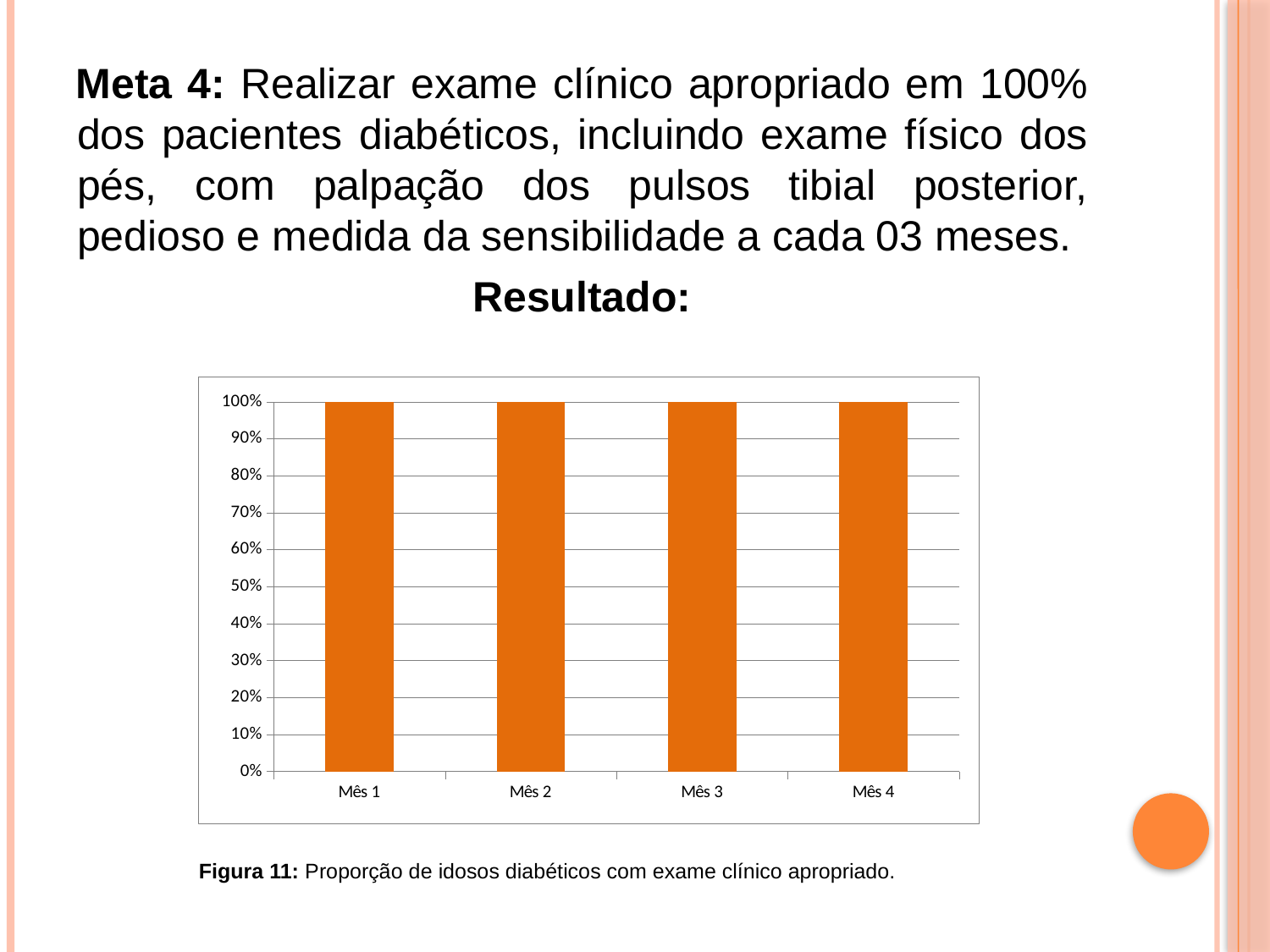
Do the values rise, fall, or stay the same from Mês 1 to Mês 4? stay the same What is the value for Mês 4 in the chart? 100% Is the value for Mês 1 greater or less than 90%? greater What is the difference between the values for Mês 1 and Mês 4? 0% What type of chart is shown on the slide? bar chart What colour are the bars in the chart? orange What is the value for Mês 1 in the chart? 100% How many categories (months) are shown on the x axis of the chart? 4 What is the label of the first category on the x axis? Mês 1 What is the value for Mês 2 in the chart? 100% What is the value for Mês 3 in the chart? 100% Is the value for Mês 3 greater or less than 50%? greater